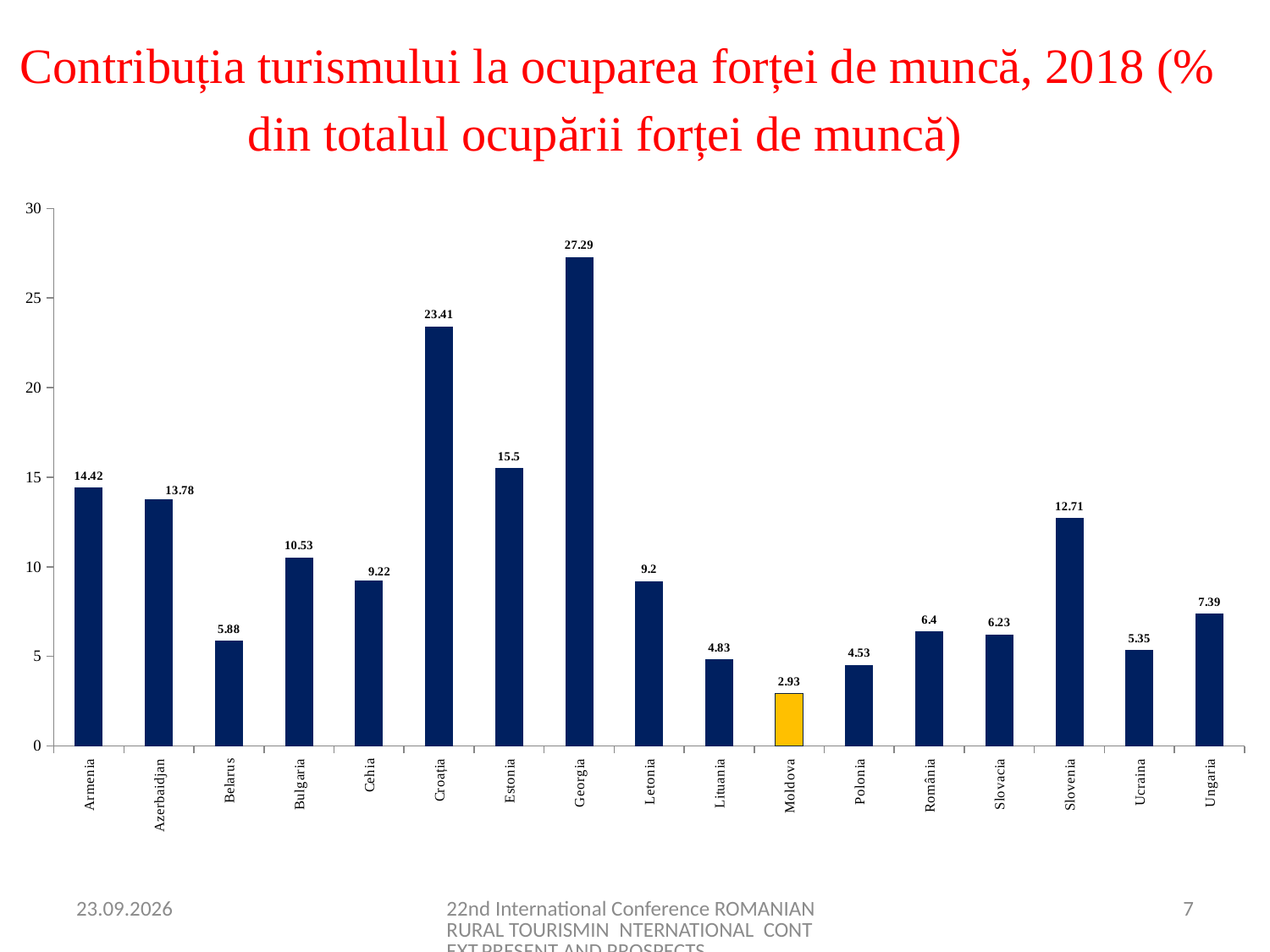
What is the difference between the values for Croația and Estonia? 7.91 Which country's bar is coloured differently (yellow) from the others? Moldova What is the value for Georgia? 27.29 What is the value for Moldova? 2.93 What is the value for Slovenia? 12.71 Is the value for Bulgaria greater or less than 10? greater Which country has the lowest value? Moldova Which is larger, the value for Armenia or the value for Azerbaidjan? Armenia How many countries are shown on the chart? 17 Which country has the highest value? Georgia What kind of chart is shown on the slide? bar chart What is the difference between the values for România and Slovacia? 0.17